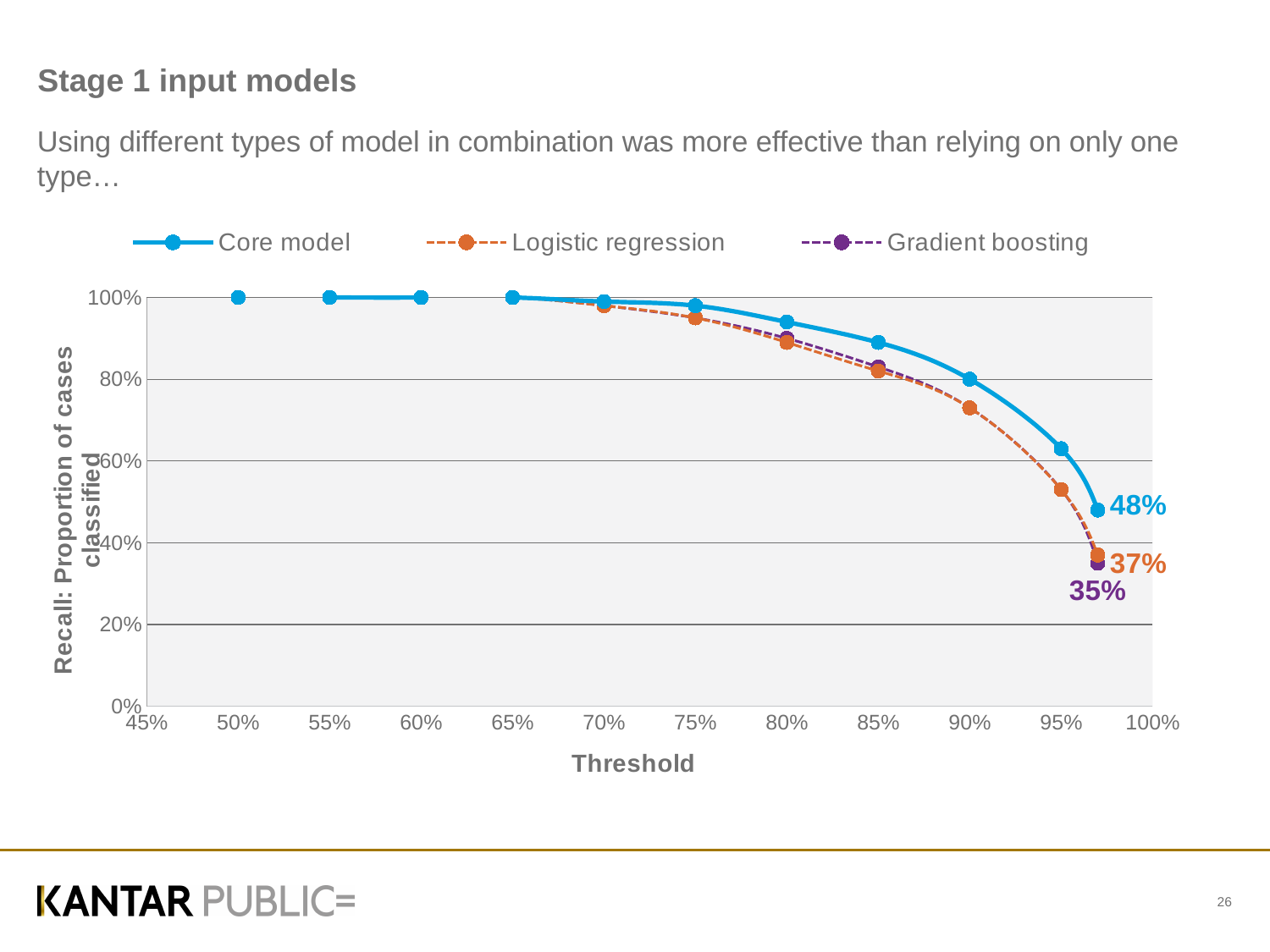
What is the final labelled recall value for the Logistic regression series? 37% Is the Core model's recall at the 95% threshold greater or less than 60%? greater What is the final labelled recall value for the Gradient boosting series? 35% How many series does the legend list? 3 Do the recall values rise or fall as the threshold increases along the x axis? Fall What kind of chart is shown on the slide? Line chart Which series has the lowest labelled recall at the end of the curves? Gradient boosting What is the difference between the final labelled recall of the Core model (48%) and Gradient boosting (35%)? 13 percentage points Is the Logistic regression's recall at the 90% threshold greater or less than 80%? less What is the final labelled recall value for the Core model series? 48% Which is larger at the end of the curves: the Core model's recall or the Logistic regression's recall? Core model Which series has the highest labelled recall at the end of the curves? Core model